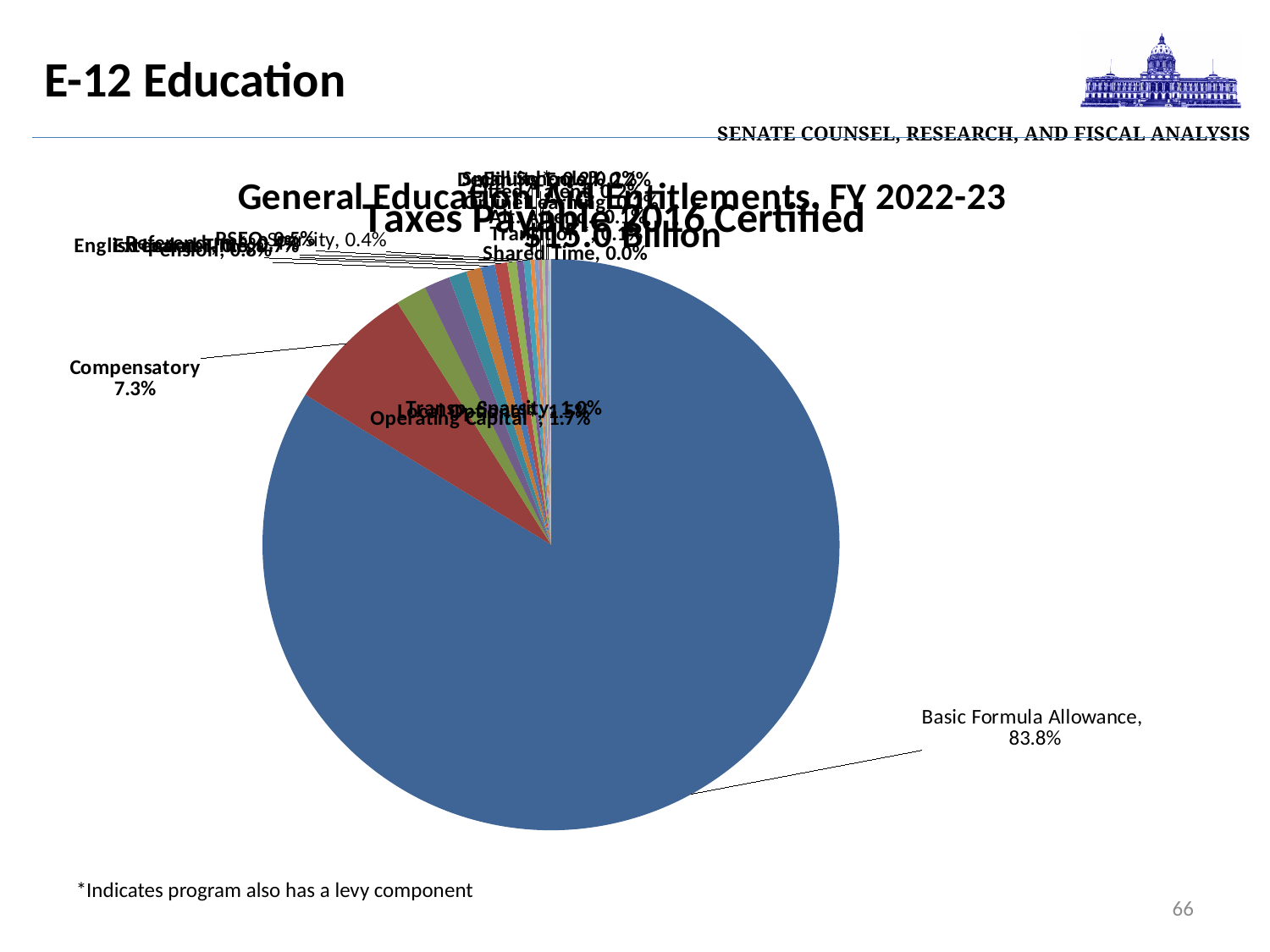
What percentage is shown for Shared Time? 0.0% What share of the pie does Basic Formula Allowance represent? 83.8% What does the footnote below the chart say the asterisk indicates? Indicates program also has a levy component What percentage is shown for Compensatory? 7.3% What is the slide's heading at the top left? E-12 Education What kind of chart is shown on the slide? pie chart Which is larger, the slice for Basic Formula Allowance or the slice for Compensatory? Basic Formula Allowance Which category has the largest slice of the pie? Basic Formula Allowance What is the difference in percentage points between Basic Formula Allowance (83.8%) and Compensatory (7.3%)? 76.5%